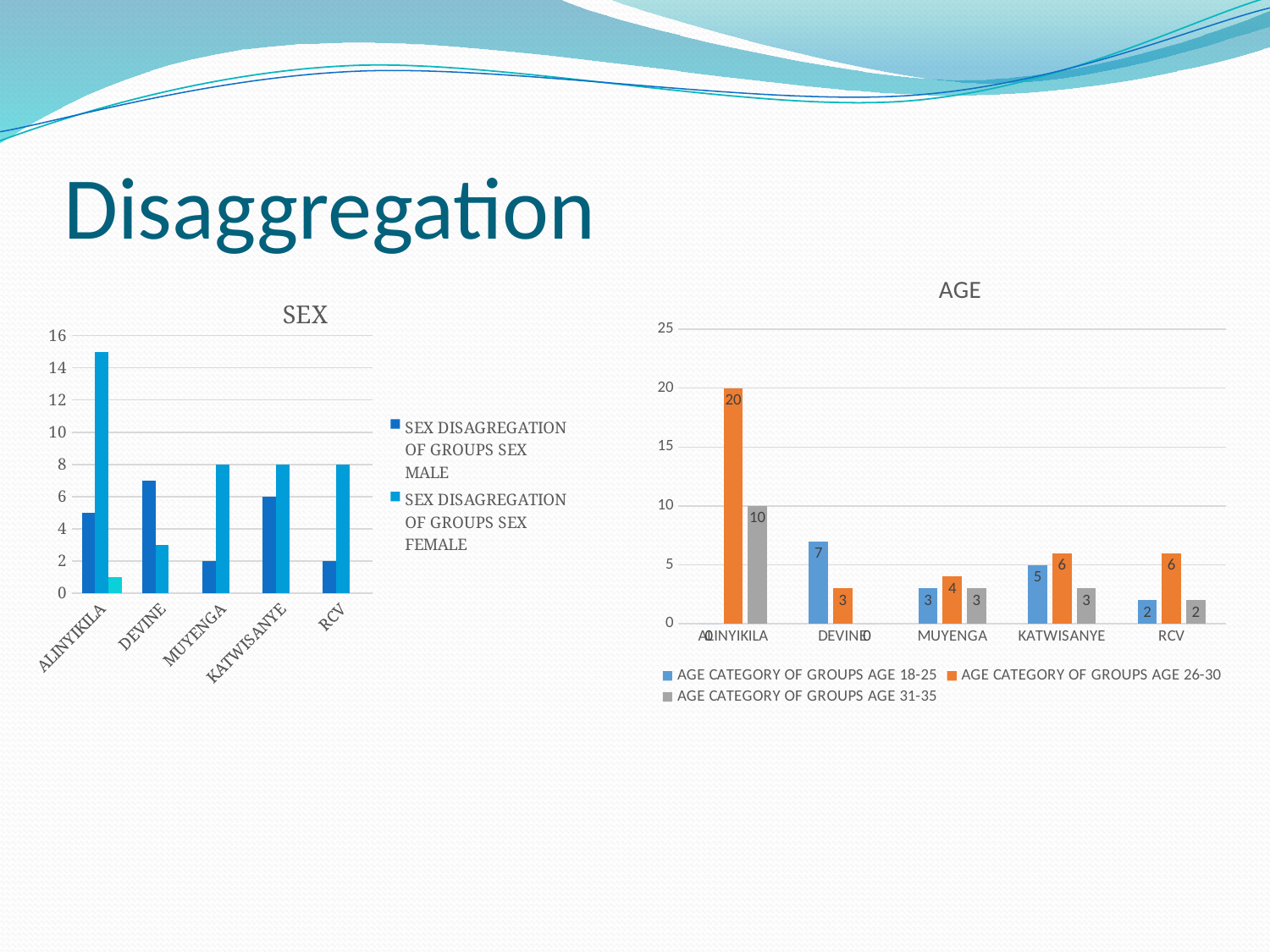
On the SEX chart, is the FEMALE value for ALINYIKILA greater or less than 14? greater On the AGE chart, which is larger in the AGE 26-30 series: MUYENGA or KATWISANYE? KATWISANYE On the AGE chart, which group has the highest value in the AGE 26-30 series? ALINYIKILA On the SEX chart, which is larger for DEVINE: the MALE value or the FEMALE value? MALE How many groups are shown on the x axis of the SEX chart? 5 On the AGE chart, what is the value for DEVINE in the AGE 18-25 series? 7 On the AGE chart, what is the value for ALINYIKILA in the AGE 26-30 series? 20 What kind of chart is the AGE chart? Bar chart On the AGE chart, what is the difference between the AGE 26-30 and AGE 31-35 values for ALINYIKILA? 10 How many series does the legend of the AGE chart list? 3 On the AGE chart, what is the value for RCV in the AGE 31-35 series? 2 On the SEX chart, which group has the highest FEMALE value? ALINYIKILA